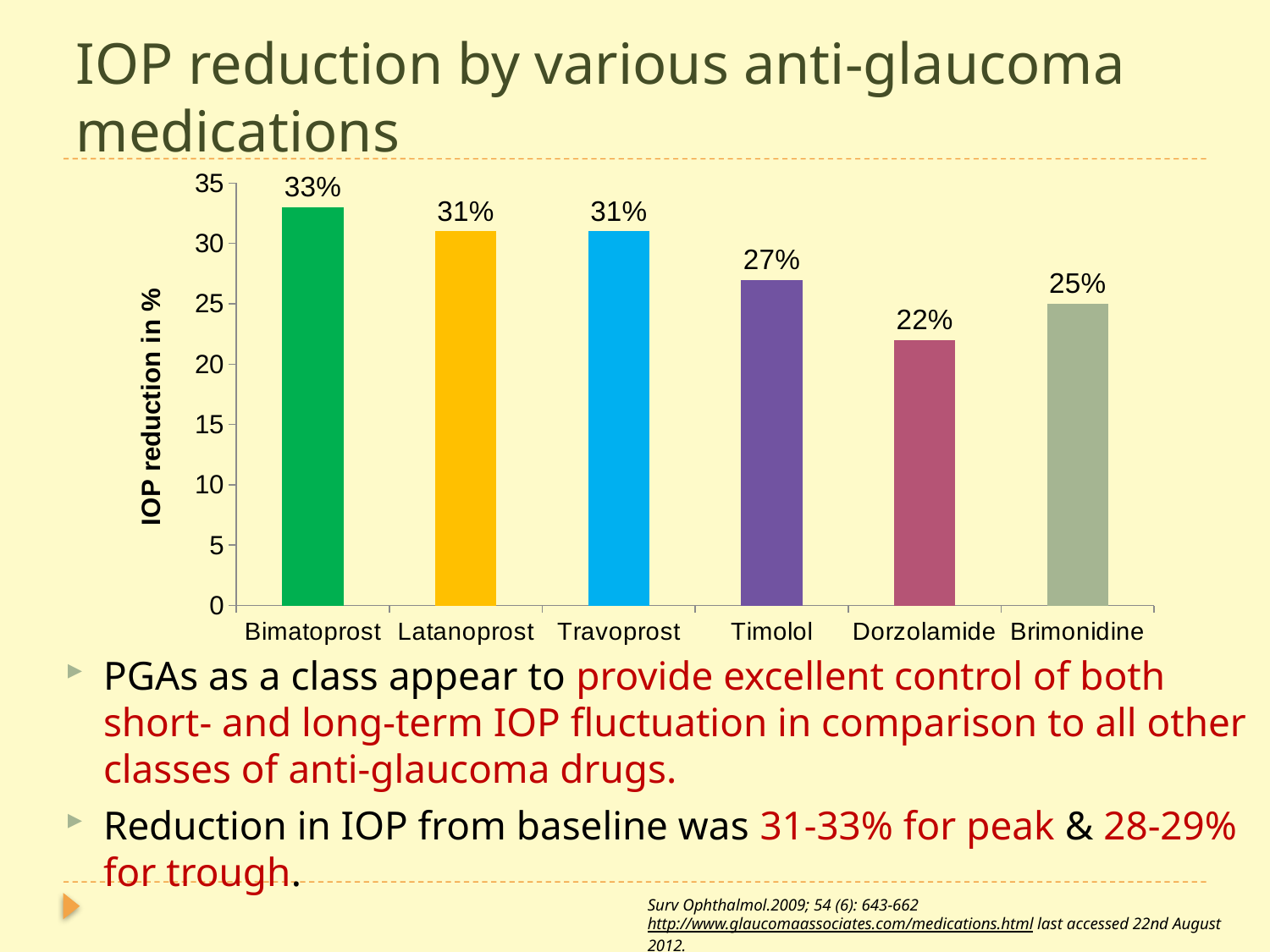
What is the label of the vertical axis of the chart? IOP reduction in % What is the IOP reduction for Bimatoprost? 33% Which medication has the lowest IOP reduction? Dorzolamide What is the IOP reduction for Dorzolamide? 22% How many medications are shown in the chart? 6 What is the IOP reduction for Timolol? 27% Which has a larger IOP reduction, Latanoprost or Timolol? Latanoprost What type of chart is shown on the slide? Bar chart What is the difference in IOP reduction between Timolol and Brimonidine? 2% Which medication has the highest IOP reduction? Bimatoprost What is the difference in IOP reduction between Bimatoprost and Dorzolamide? 11% What is the IOP reduction for Brimonidine? 25%